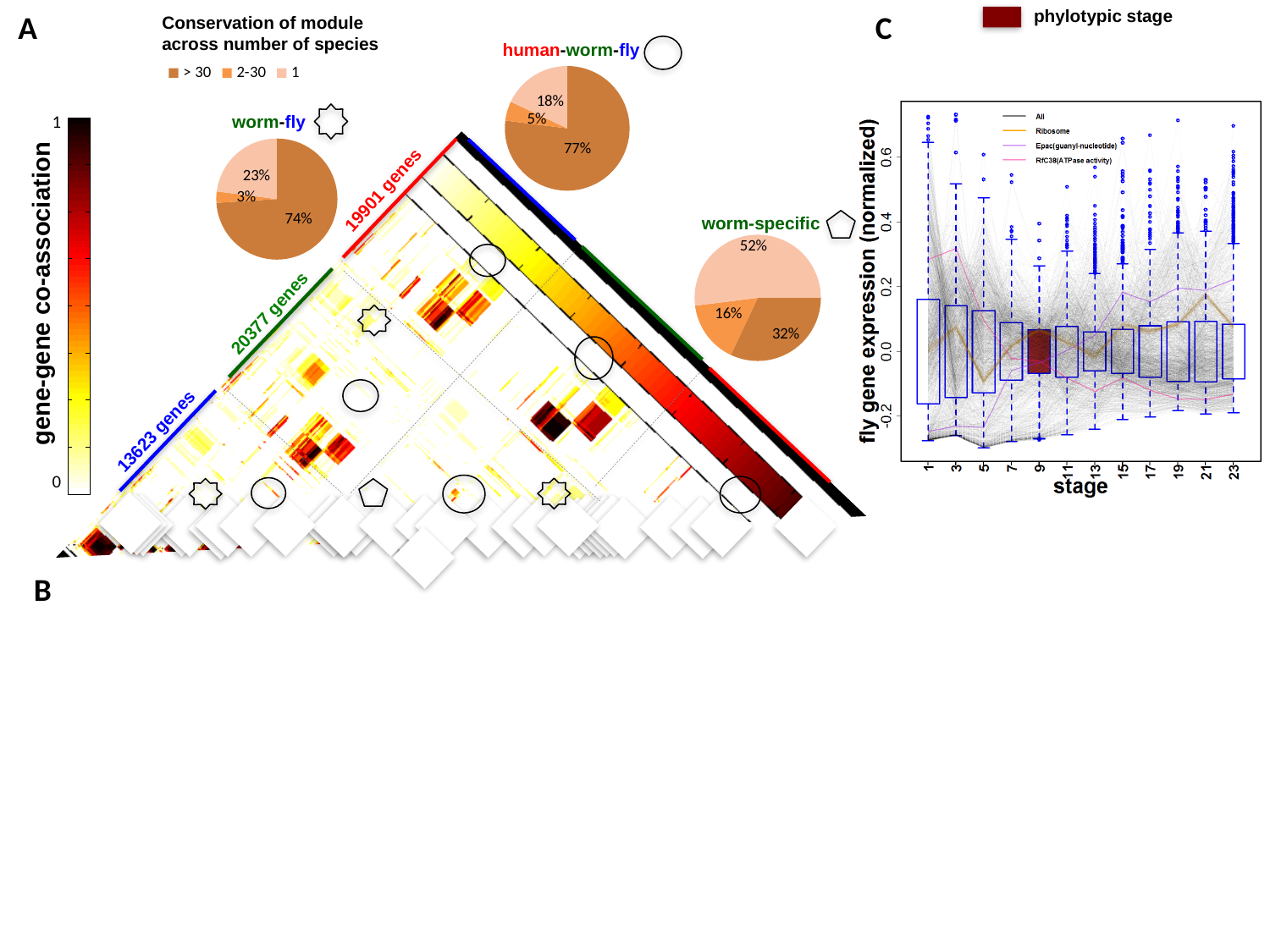
In the worm-specific pie chart, what percentage of modules is conserved across 2-30 species? 16% How many series does the legend in panel C list? 4 In panel C, which stage is highlighted as the phylotypic stage? 9 How many conservation categories does the pie chart legend list? 3 In the worm-fly pie chart, which conservation category has the smallest share? 2-30 In the worm-fly pie chart, what share of modules is conserved across more than 30 species? 74% What kind of chart is shown in panel C? box plot How many stages are shown on the x axis of the panel C box plot? 12 In the worm-specific pie chart, which conservation category has the largest share? 1 What is the difference between the >30 share in the human-worm-fly pie chart and the >30 share in the worm-fly pie chart? 3% Which is larger: the 1-species share in the worm-specific pie chart or the 1-species share in the worm-fly pie chart? worm-specific In the human-worm-fly pie chart, what percentage of modules is conserved in only 1 species? 18%